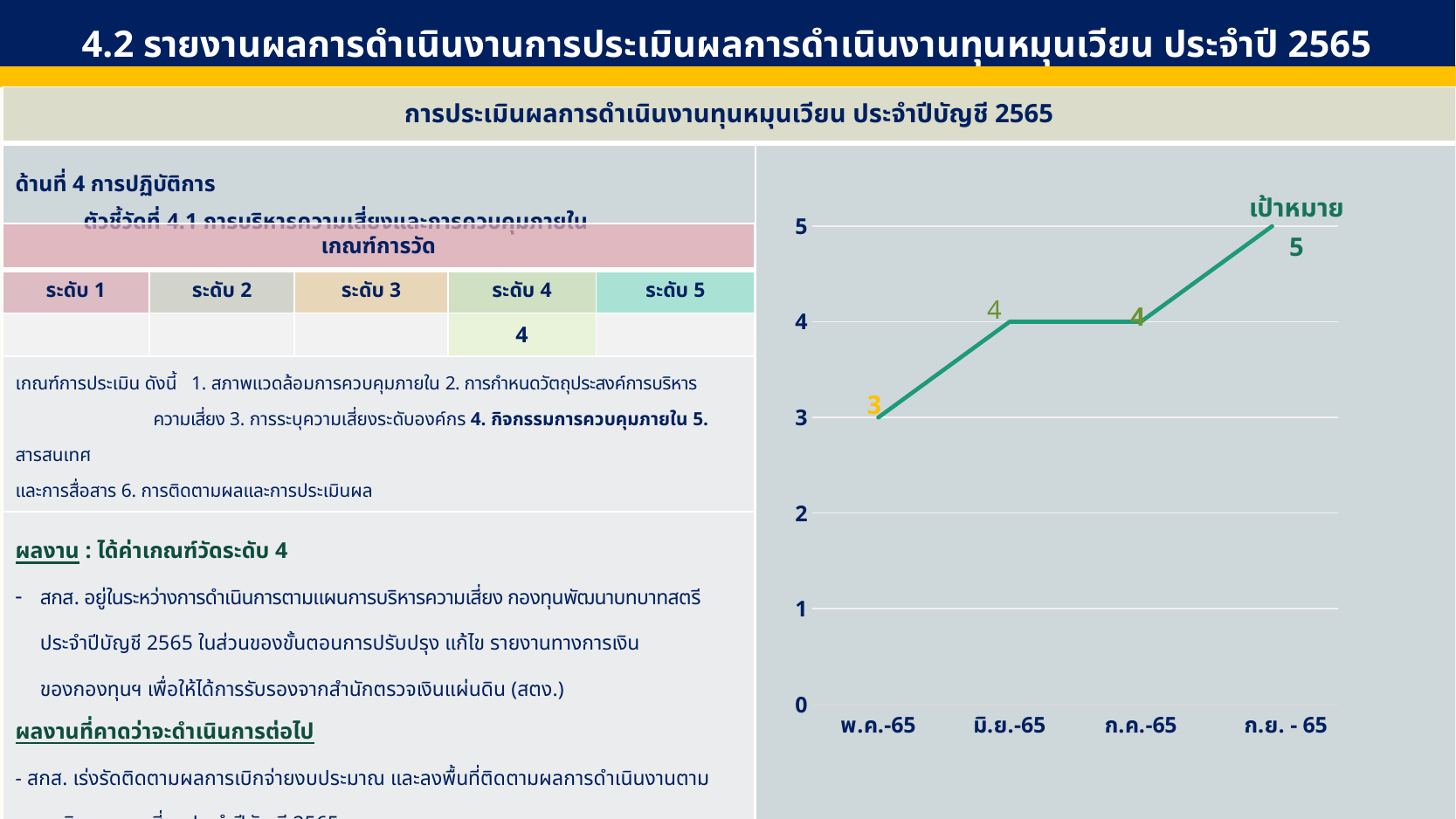
What label is written next to the last point of the line chart? เป้าหมาย Which month has the highest value on the line chart? ก.ย. - 65 What is the value plotted for มิ.ย.-65? 4 Which is larger, the value for มิ.ย.-65 or the value for พ.ค.-65? มิ.ย.-65 What is the value plotted for ก.ย. - 65? 5 Do the values on the line chart rise or fall from พ.ค.-65 to ก.ย. - 65? rise What is the value plotted for ก.ค.-65? 4 How many data points are plotted on the line chart? 4 What kind of chart is shown on the right side of the slide? line chart What is the value plotted for พ.ค.-65? 3 What is the difference between the value for ก.ย. - 65 and the value for พ.ค.-65? 2 Which month has the lowest value on the line chart? พ.ค.-65